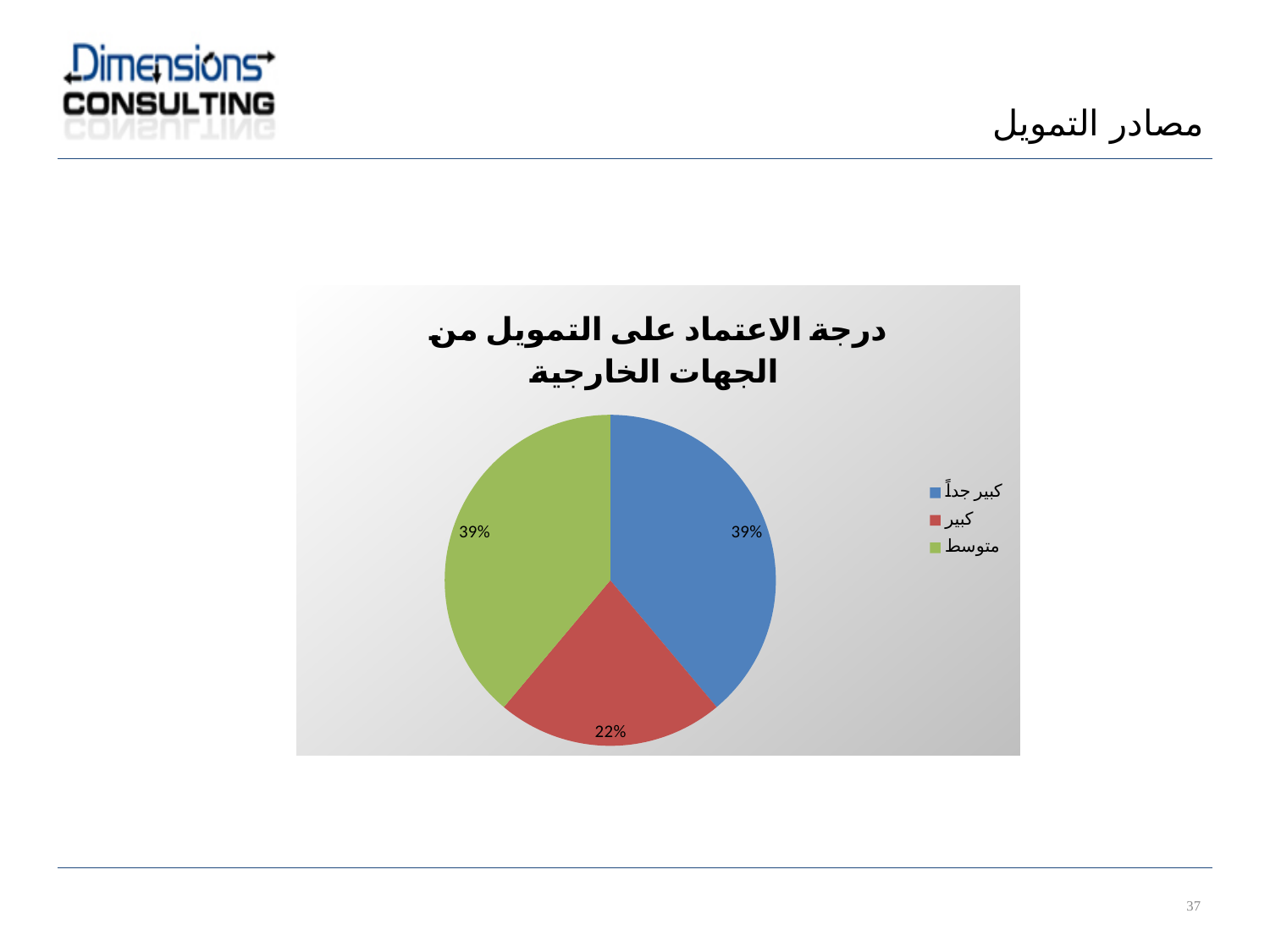
What kind of chart is shown on the slide? Pie chart Which is larger, the share for كبير جداً or the share for كبير? كبير جداً What share of the pie does the متوسط slice represent? 39% How many entries does the legend list? 3 What is the title of the chart? درجة الاعتماد على التمويل من الجهات الخارجية Which category has the smallest slice of the pie? كبير How many slices does the pie chart have? 3 What share of the pie does the كبير جداً slice represent? 39% What share of the pie does the كبير slice represent? 22% What is the difference in percentage points between the متوسط slice and the كبير slice? 17 Which colour represents the متوسط category in the pie chart? Green